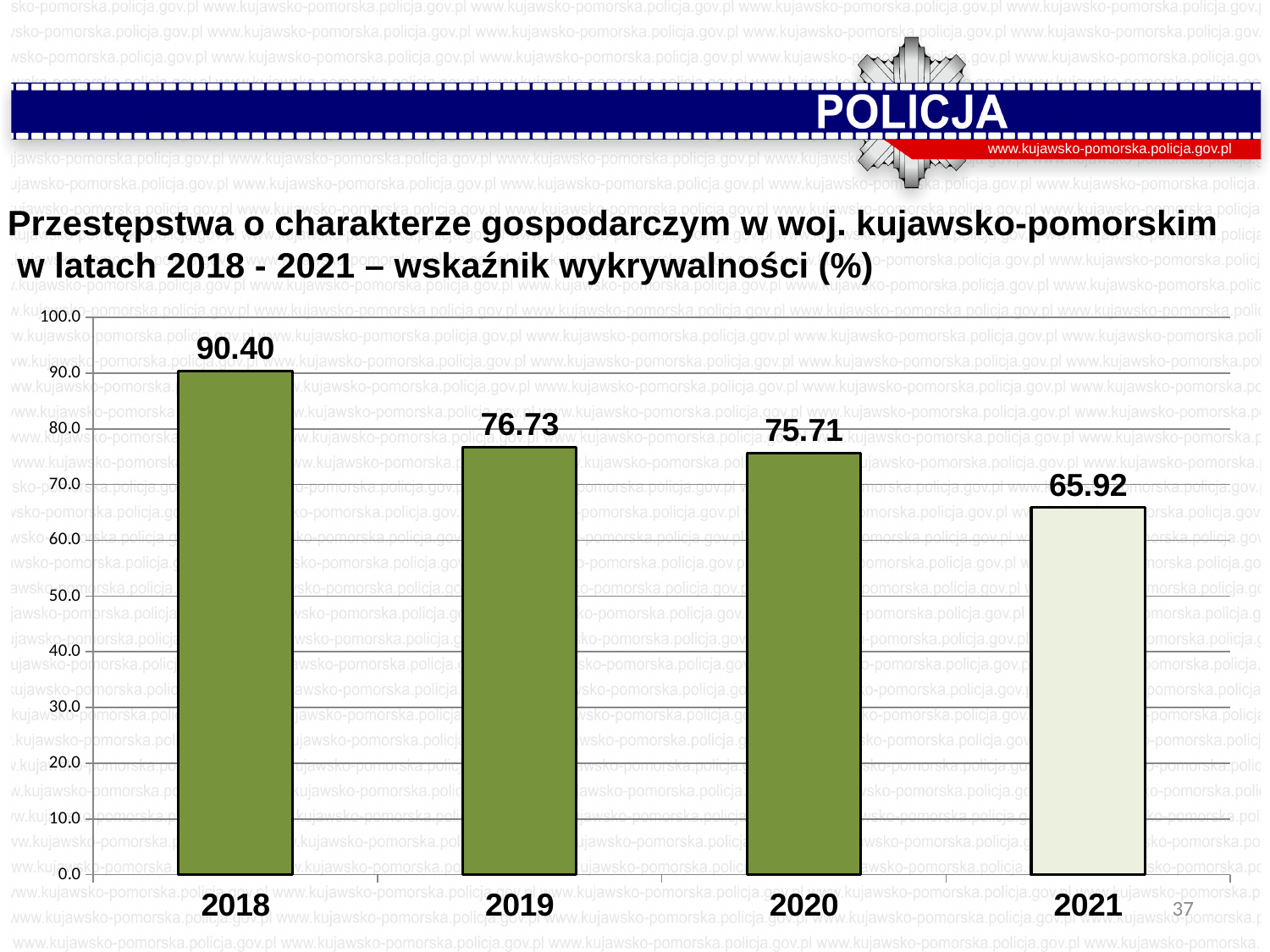
How many years are shown on the x axis? 4 Do the values rise or fall from 2018 to 2021? fall Which year has the highest detection rate? 2018 Is the value for 2020 greater or less than 70.0? greater What is the detection rate value shown for 2018? 90.40 What kind of chart is shown on the slide? bar chart What is the difference between the values for 2019 and 2020? 1.02 What is the difference between the values for 2018 and 2021? 24.48 Which year has the lowest detection rate? 2021 What is the detection rate value shown for 2021? 65.92 Which is larger, the value for 2019 or the value for 2021? 2019 What is the value shown for 2019? 76.73